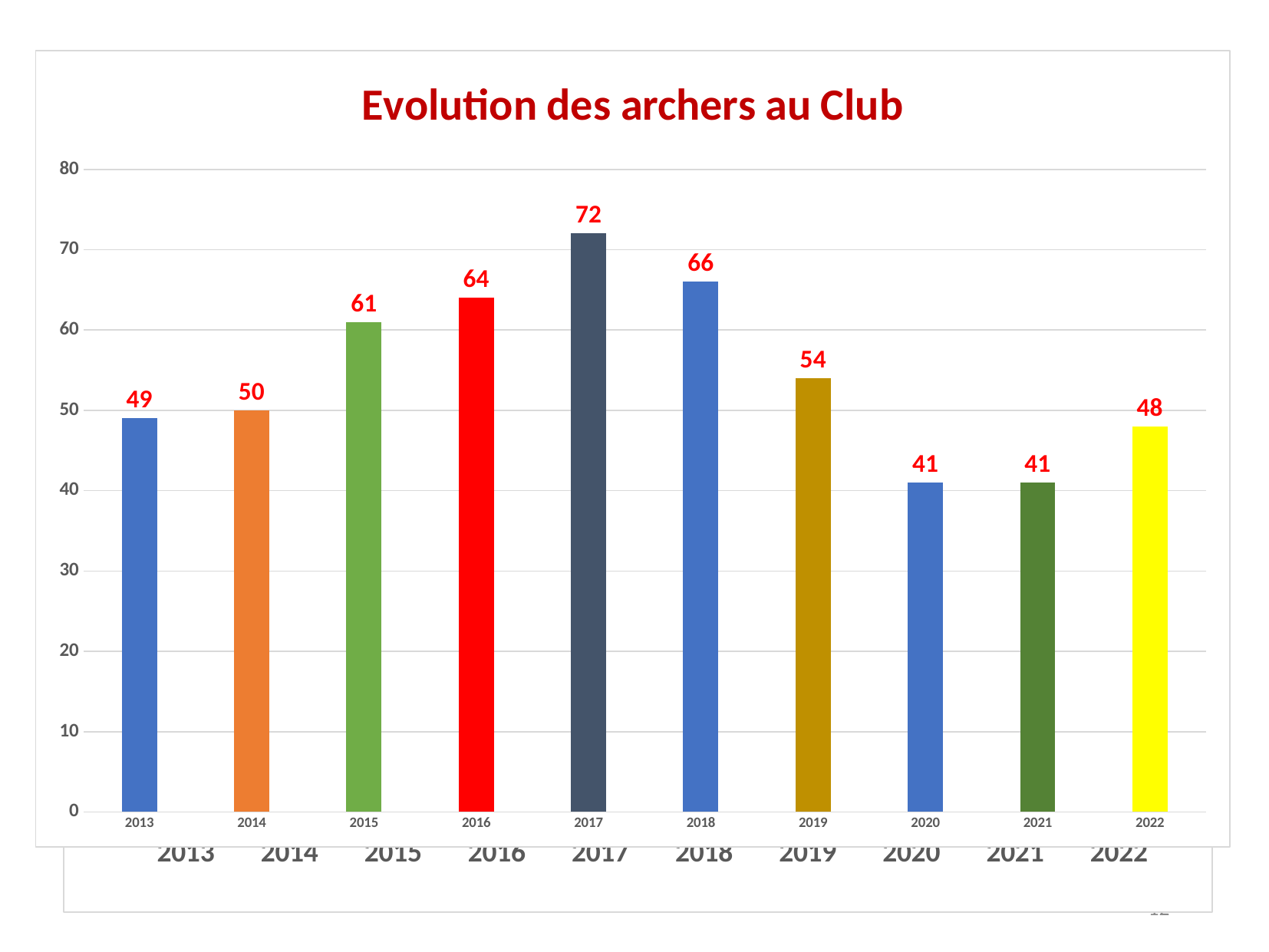
Which year has the highest value? 2017 What is the difference between the values for 2019 and 2020? 13 What is the value for 2017? 72 What kind of chart is this? bar chart What is the value for 2022? 48 Is the value for 2018 greater or less than 60? greater What is the title of the chart? Evolution des archers au Club What is the lowest value shown on the chart? 41 What is the difference between the values for 2017 and 2018? 6 What is the value for 2019? 54 Which is larger, the value for 2015 or the value for 2016? 2016 How many years are shown on the x axis? 10